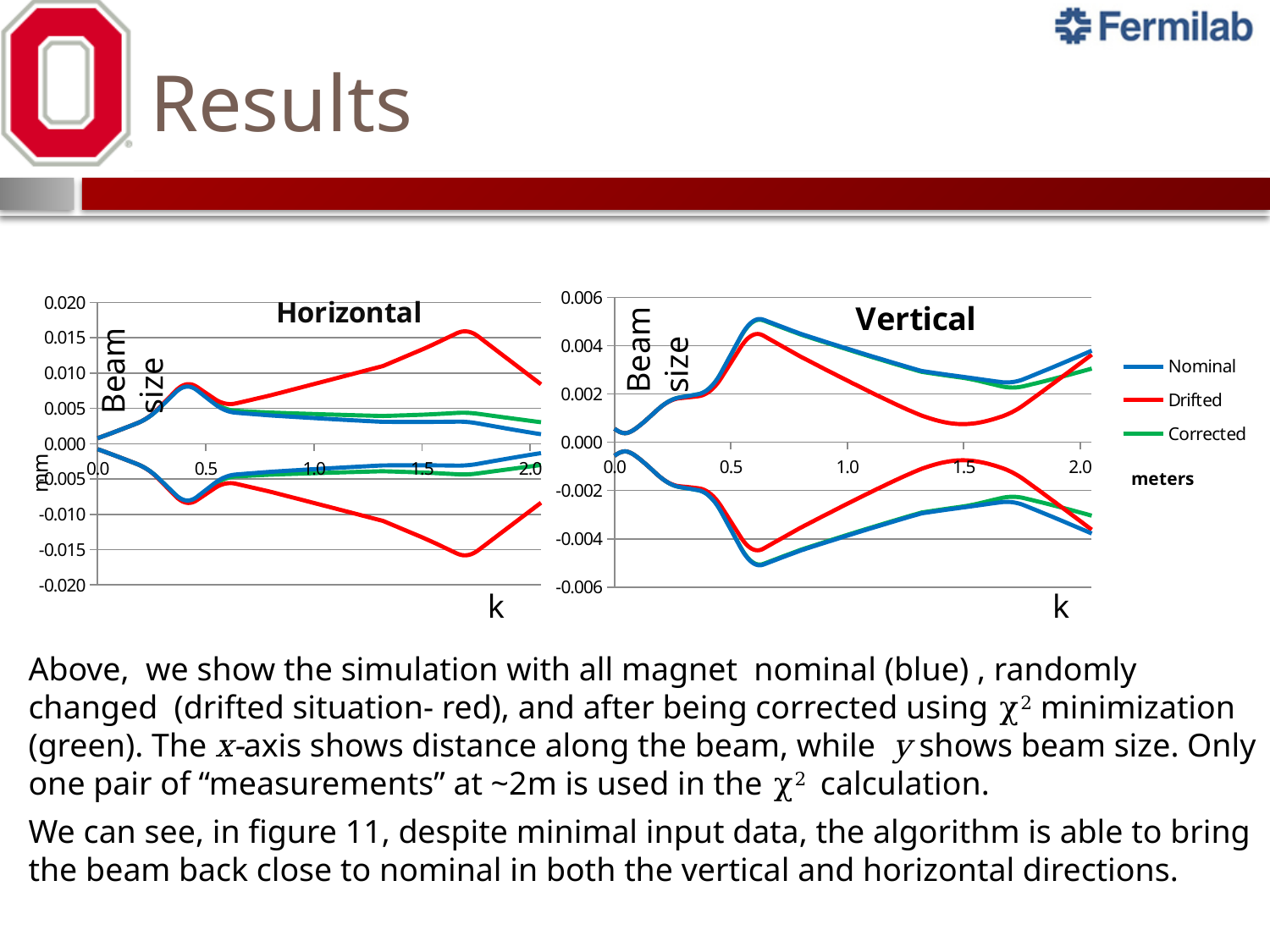
What is the title of the chart on the right? Vertical In the Vertical chart, is the upper Drifted curve at x = 1.5 greater or less than 0.002? less In the Vertical chart, at x = 1.5, which upper curve is larger: Nominal or Drifted? Nominal In the Horizontal chart, is the peak value of the Nominal series greater or less than 0.010? less In the Horizontal chart, is the peak value of the Drifted series greater or less than 0.010? greater What kind of chart is the Horizontal chart? line chart In the Horizontal chart, which series reaches the highest value on the y axis? Drifted Which series is drawn in red in the legend? Drifted In the Vertical chart, does the upper Drifted curve rise or fall between x = 0.6 and x = 1.5? fall In the Horizontal chart, does the upper Drifted curve rise or fall between x = 0.5 and x = 1.5? rise How many series does the legend list for the charts? 3